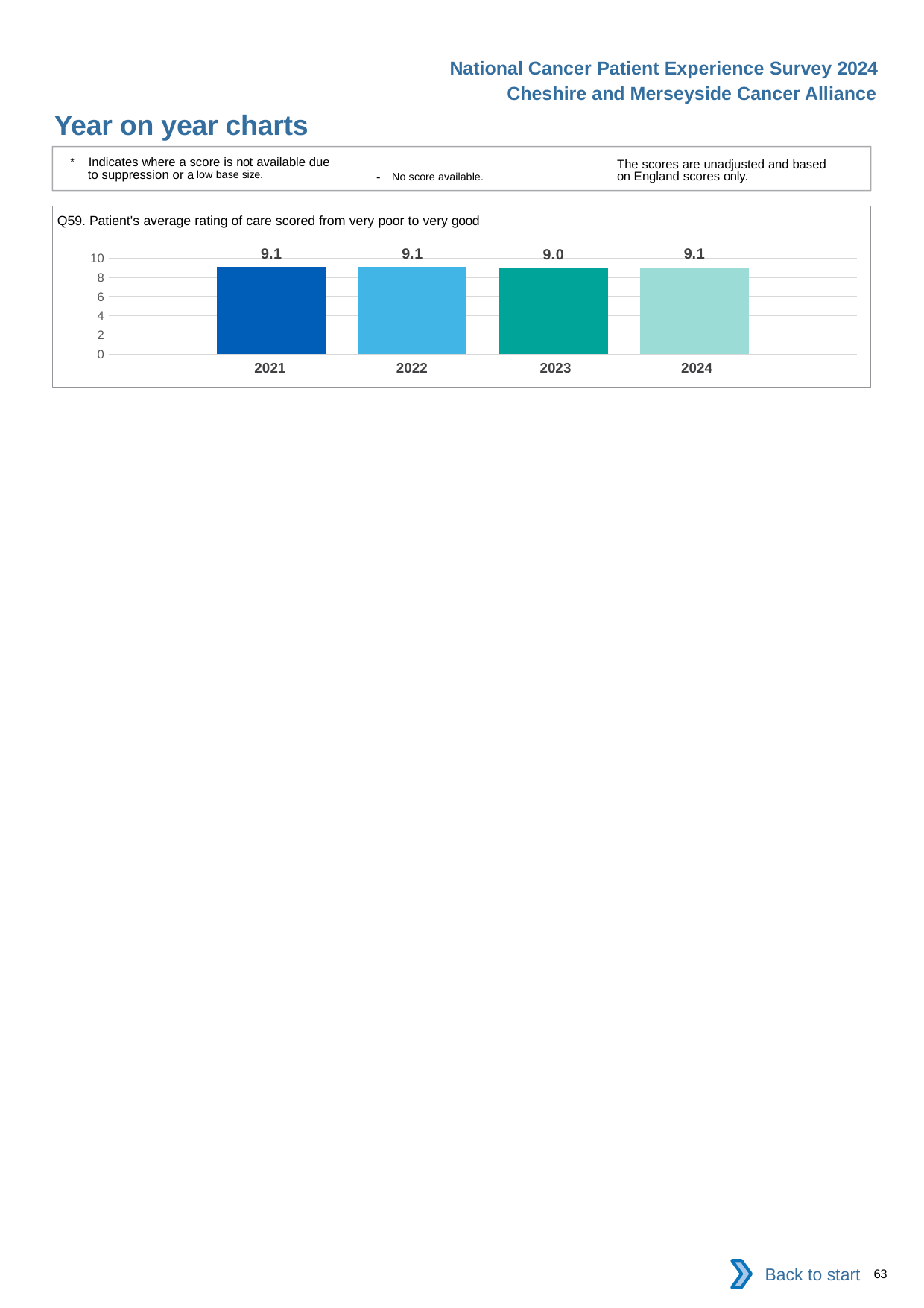
Is the value for 2023 greater or less than 10? less Which year has the lowest value? 2023 What is the value for 2023? 9.0 What is the highest value shown on the y axis? 10 Is the value for 2022 greater or less than 8? greater What kind of chart is this? Bar chart What is the title of the chart? Q59. Patient's average rating of care scored from very poor to very good What is the value for 2021? 9.1 What is the value for 2024? 9.1 How many years are shown on the chart? 4 What is the difference between the values for 2022 and 2023? 0.1